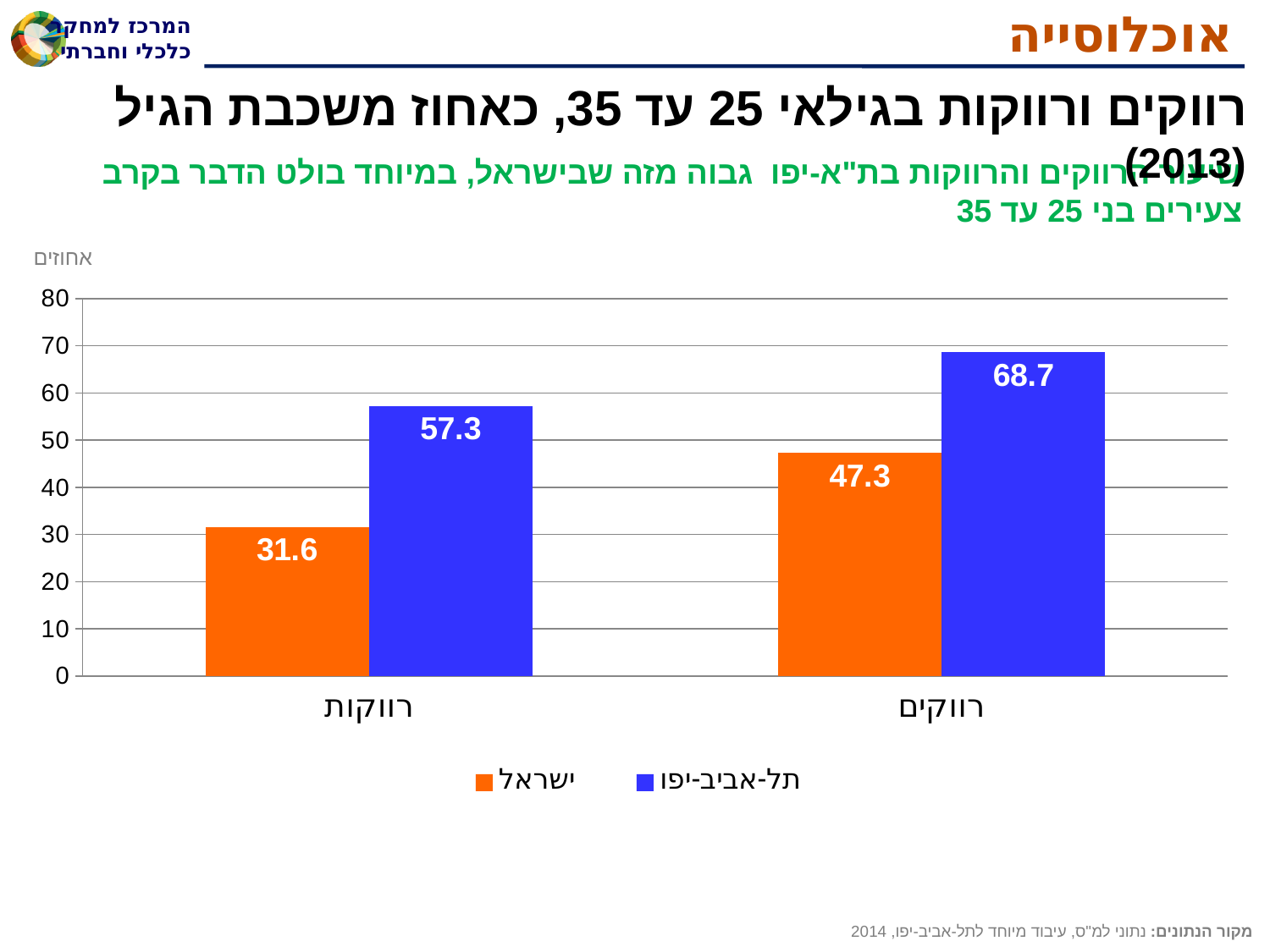
How many series does the legend list? 2 Which bar has the highest value on the chart? תל-אביב-יפו, רווקים What is the value for תל-אביב-יפו in the רווקות category? 57.3 What is the value for ישראל in the רווקות category? 31.6 What kind of chart is shown on the slide? Bar chart What is the difference between the תל-אביב-יפו and ישראל values in the רווקים category? 21.4 Which bar has the lowest value on the chart? ישראל, רווקות What is the value for תל-אביב-יפו in the רווקים category? 68.7 Which is larger: the ישראל value for רווקים or the תל-אביב-יפו value for רווקות? תל-אביב-יפו value for רווקות What is the value for ישראל in the רווקים category? 47.3 What is the difference between the תל-אביב-יפו and ישראל values in the רווקות category? 25.7 How many categories are shown on the x axis? 2